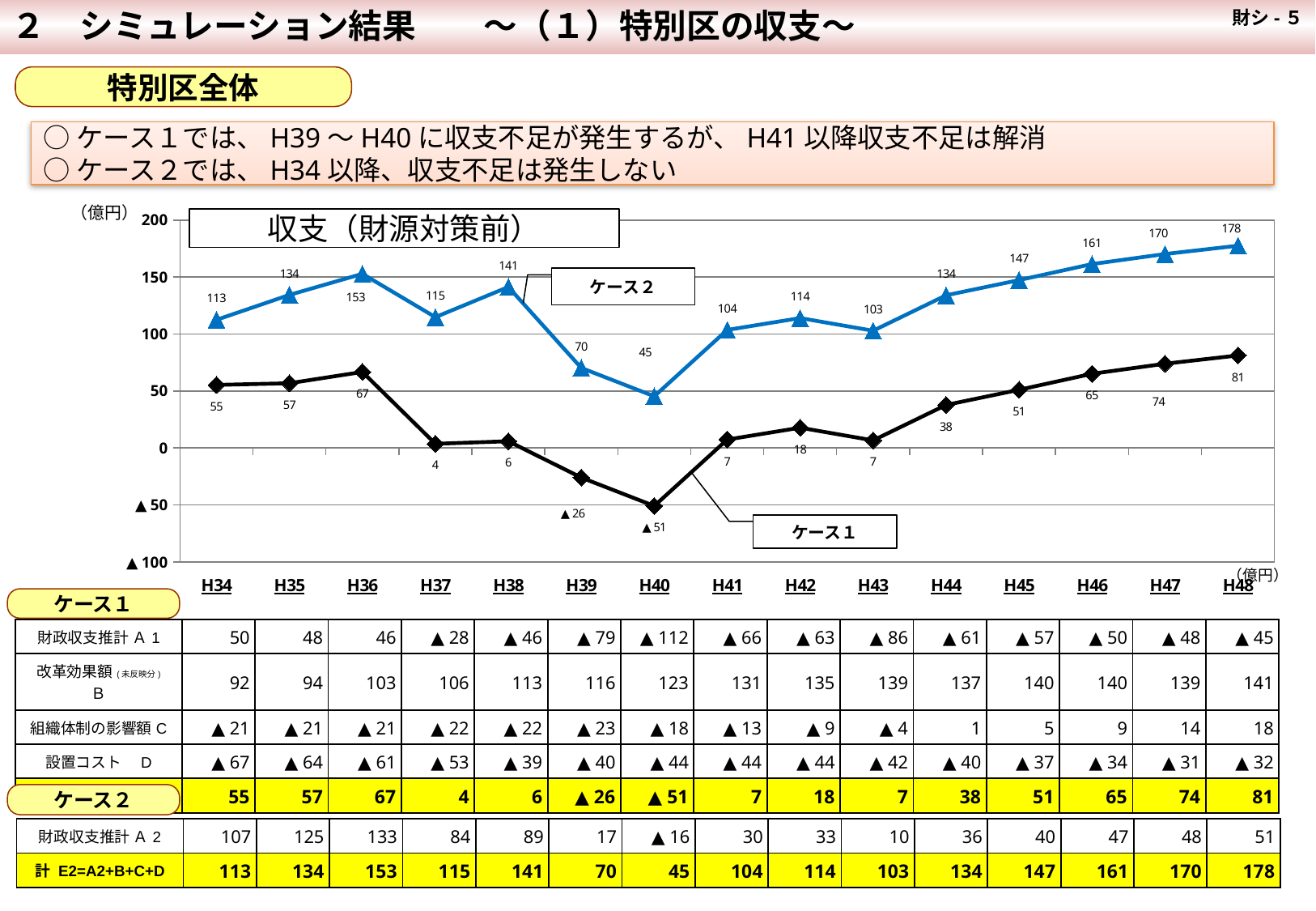
What is the value for ケース1 at H40? ▲51 What is the value for ケース2 at H36? 153 How many series does the chart show? 2 What kind of chart is shown on the slide? line chart What is the value for ケース2 at H48? 178 At which year is ケース1 at its lowest? H40 How many points along the x axis (H34 to H48) does each line have? 15 Which is larger at H39, the value for ケース1 or the value for ケース2? ケース2 At which year is ケース2 at its highest? H48 What is the difference between ケース2 and ケース1 at H38? 135 What is the title of the chart? 収支（財源対策前） Does ケース2 rise or fall from H44 to H48? rise